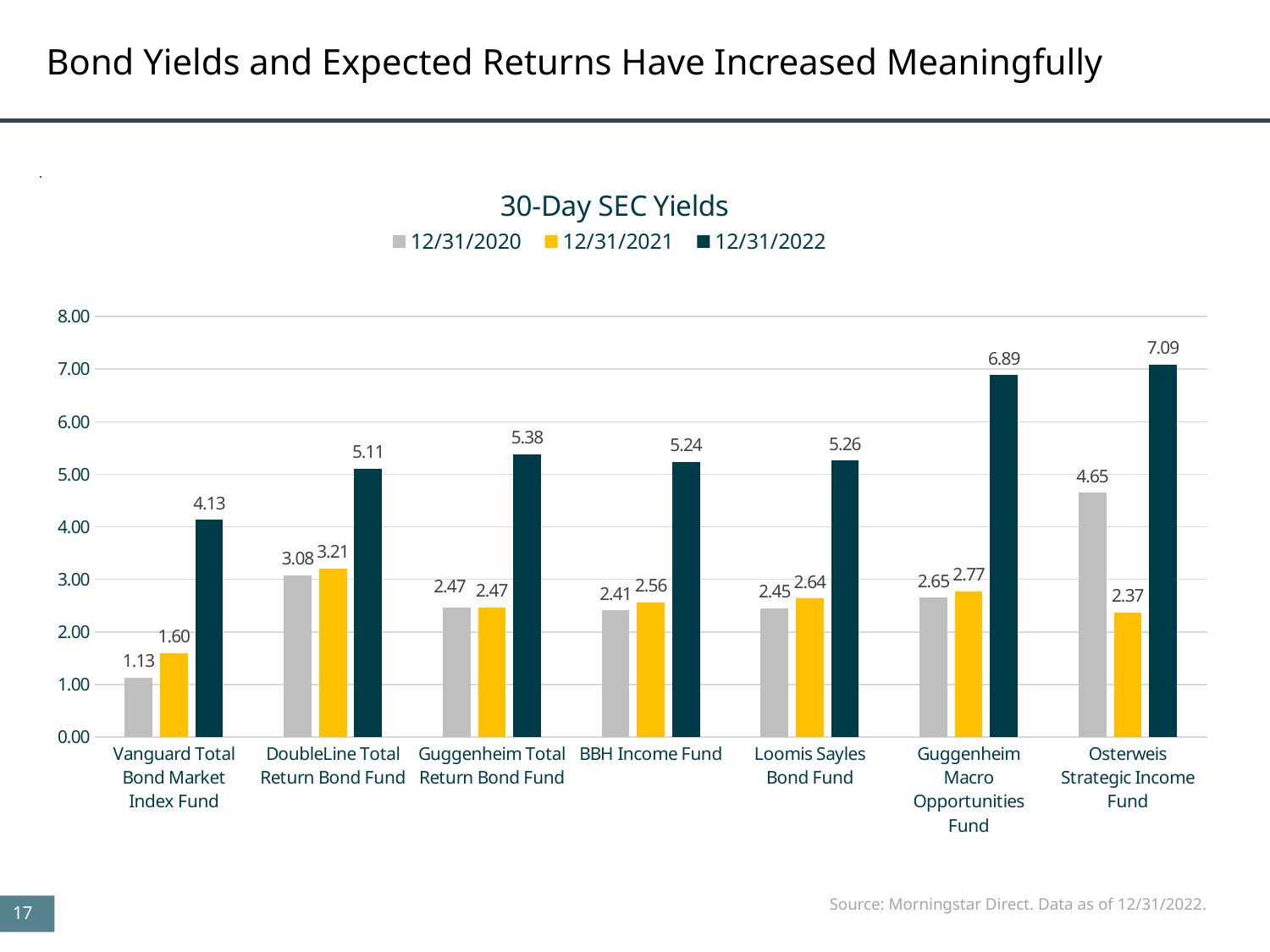
What is the 12/31/2021 30-Day SEC Yield for the Loomis Sayles Bond Fund? 2.64 What is the difference between the 12/31/2022 and 12/31/2021 yields for the Guggenheim Macro Opportunities Fund? 4.12 What kind of chart is shown on the slide? Bar chart Which colour represents the 12/31/2021 series? Yellow How many series does the legend list? 3 What is the 12/31/2020 30-Day SEC Yield for the Vanguard Total Bond Market Index Fund? 1.13 Which fund has the lowest 12/31/2020 30-Day SEC Yield? Vanguard Total Bond Market Index Fund Which is larger for the Osterweis Strategic Income Fund: the 12/31/2020 yield or the 12/31/2021 yield? 12/31/2020 What is the title of the chart? 30-Day SEC Yields Which fund has the highest 12/31/2022 30-Day SEC Yield? Osterweis Strategic Income Fund What is the 12/31/2022 30-Day SEC Yield for the Osterweis Strategic Income Fund? 7.09 How many funds are shown on the chart? 7